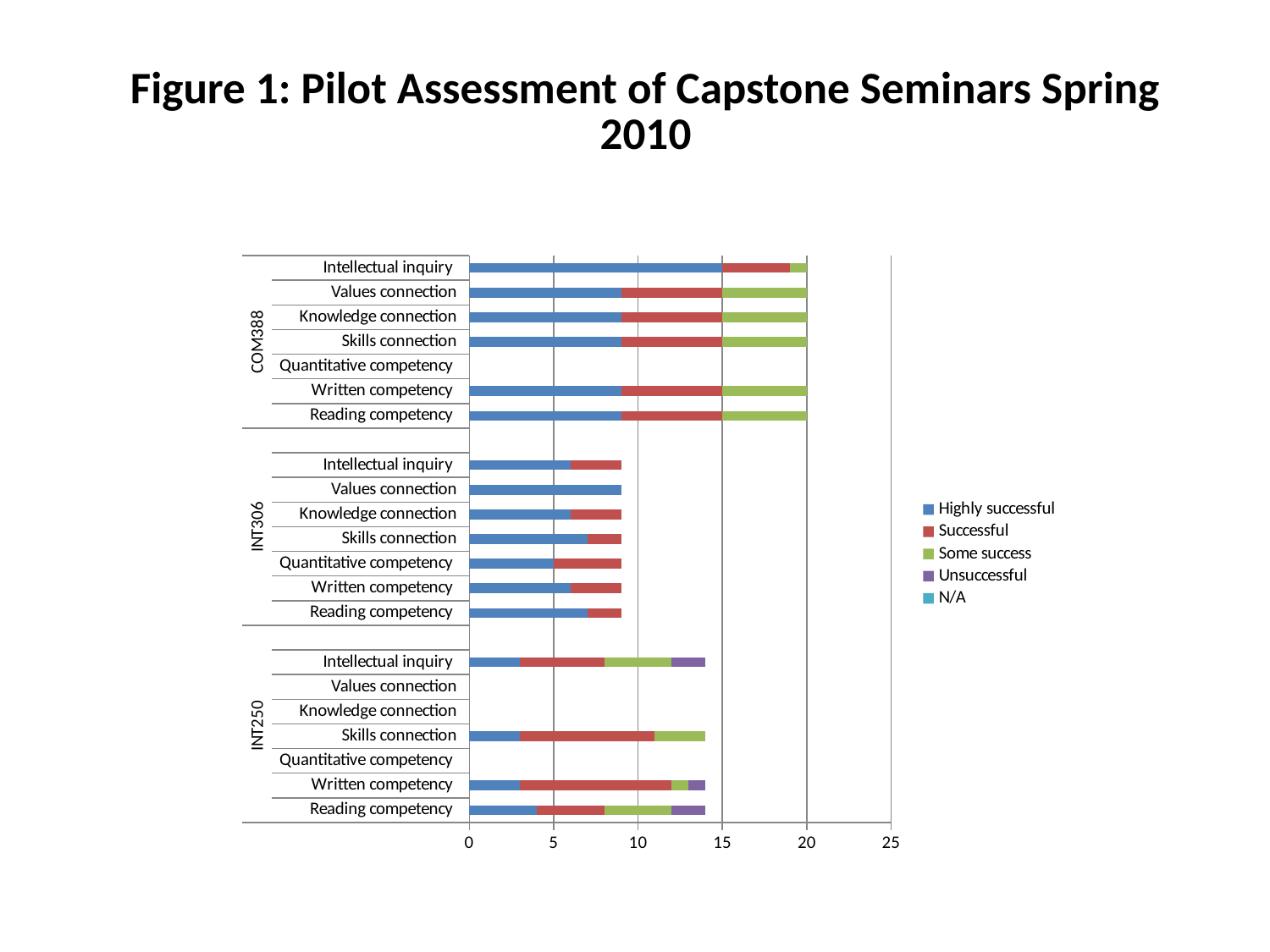
What are the legend entries of the chart? Highly successful, Successful, Some success, Unsuccessful, N/A Is the total bar for Reading competency under COM388 greater or less than 15? greater How many categories are listed under each course (e.g. COM388)? 7 What kind of chart is shown on the slide? Stacked bar chart How many series does the legend list? 5 What is the Highly successful value for Intellectual inquiry under COM388? 15 Is the total bar for Values connection under INT306 greater or less than 10? less What is the total length of the stacked bar for Values connection under COM388? 20 Is the total bar for Reading competency under INT250 greater or less than 10? greater What is the Highly successful value for Quantitative competency under INT306? 5 What is the title of the chart? Figure 1: Pilot Assessment of Capstone Seminars Spring 2010 Which has the longer total bar for Skills connection: COM388 or INT250? COM388